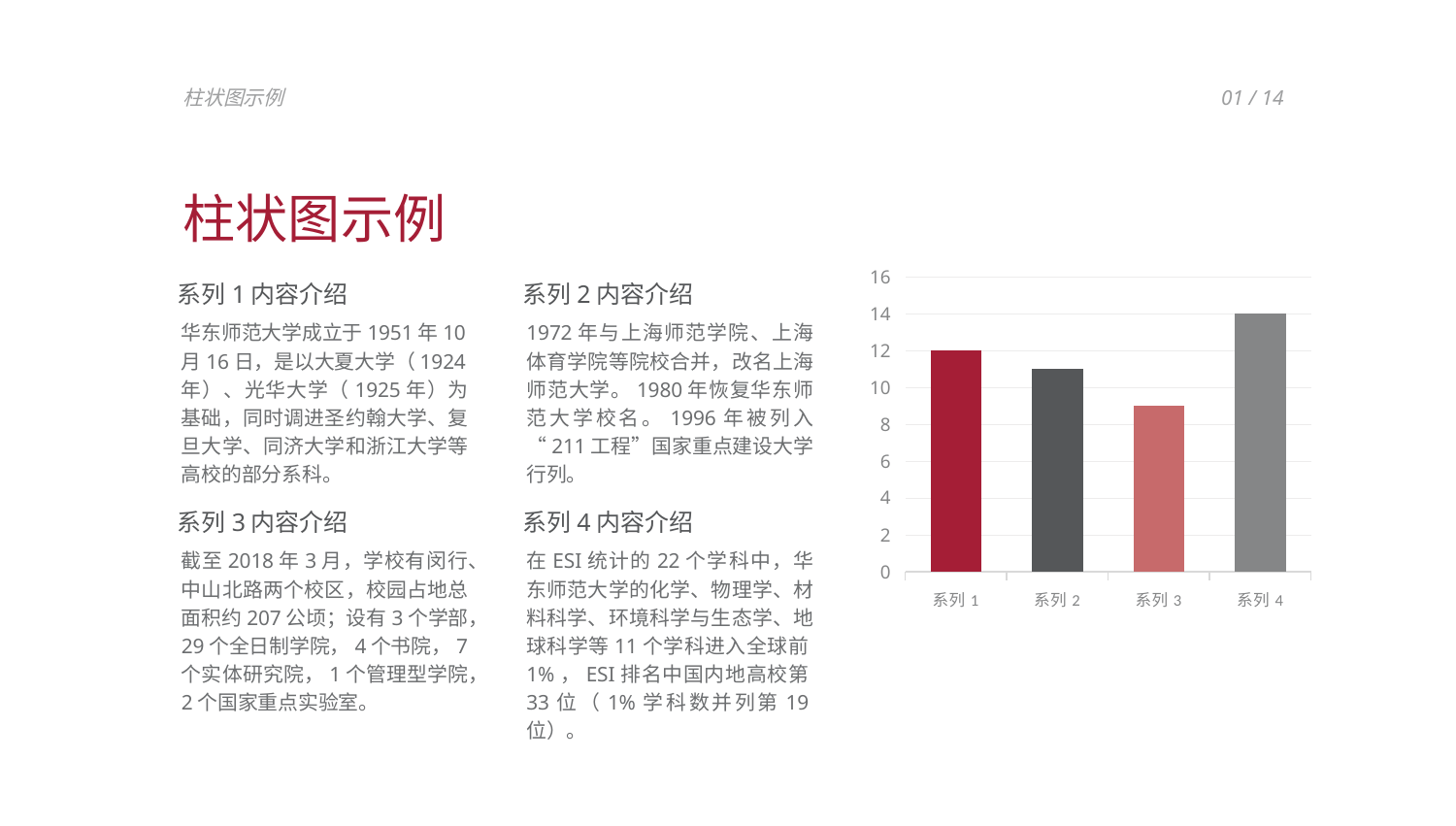
What is the highest value shown on the vertical axis? 16 Which category has the highest bar? 系列 4 What type of chart is shown on the slide? Bar chart What colour is the bar for 系列 1? Dark red How many bars (categories) are plotted in the chart? 4 Is the value for 系列 2 greater or less than 10? greater Which category has the lowest bar? 系列 3 Which is larger, the value for 系列 4 or the value for 系列 3? 系列 4 Is the value for 系列 3 greater or less than 10? less What is the value of the bar for 系列 4? 14 What is the value of the bar for 系列 1? 12 What is the difference between the values for 系列 4 and 系列 1? 2